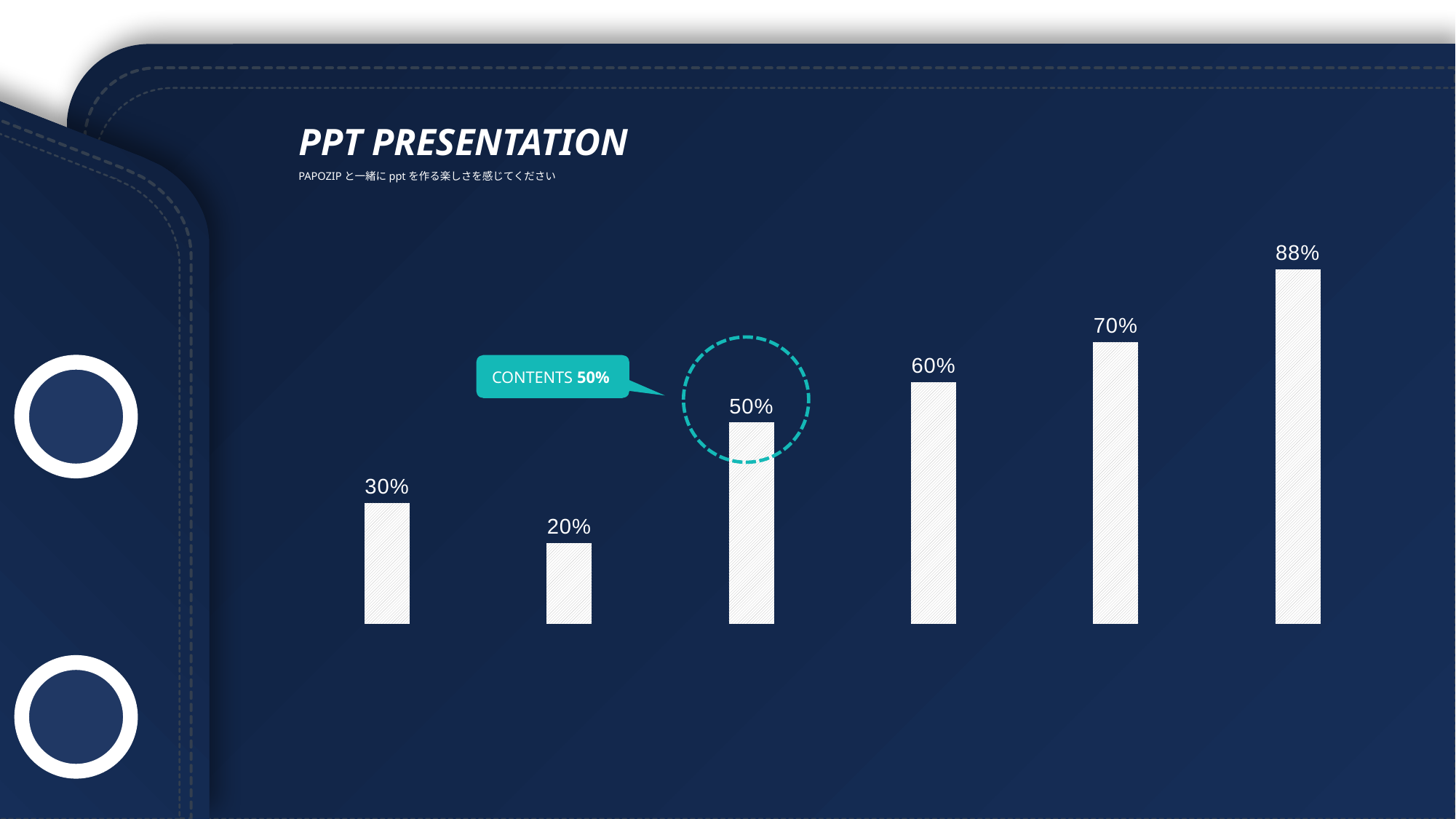
How many bars are plotted in the chart? 6 What kind of chart is shown on the slide? bar chart From the third bar to the sixth bar, do the values rise or fall? rise What does the teal callout box next to the dashed circle say? CONTENTS 50% What is the value labelled on the shortest bar? 20% What is the difference between the first bar (30%) and the second bar (20%)? 10% What value is labelled on the first (leftmost) bar? 30% What value is labelled on the fourth bar from the left? 60% What value is labelled on the bar highlighted by the dashed circle? 50% Which is larger, the value of the first bar or the value of the second bar? the first bar (30%) What is the difference between the rightmost bar (88%) and the fifth bar (70%)? 18% What is the value labelled on the tallest bar? 88%